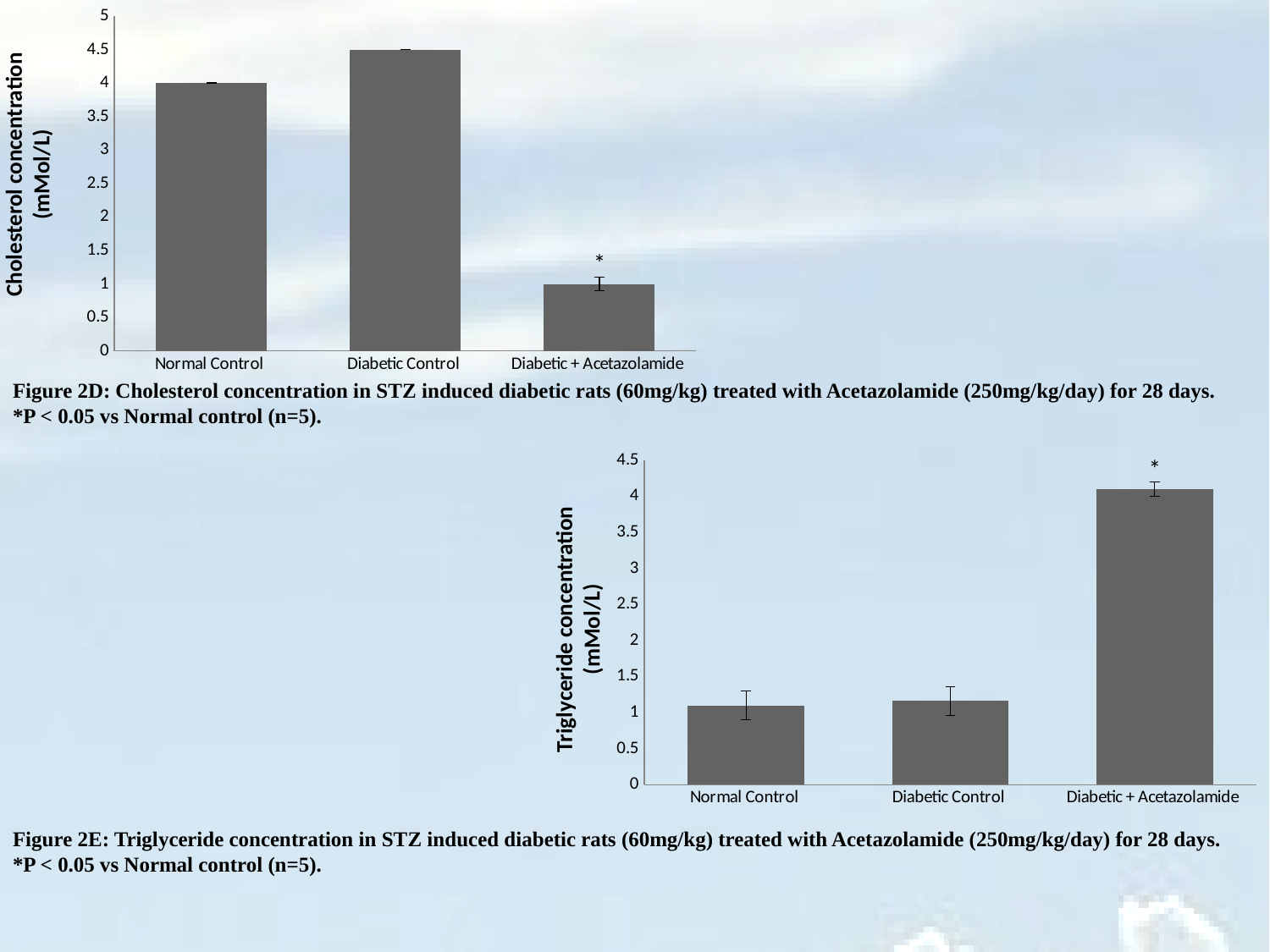
In the cholesterol concentration chart (Figure 2D), which group's bar is marked with an asterisk (*)? Diabetic + Acetazolamide In the triglyceride concentration chart (Figure 2E), which is larger: the value for Diabetic + Acetazolamide or the value for Diabetic Control? Diabetic + Acetazolamide In the cholesterol concentration chart (Figure 2D), which group has the lowest cholesterol concentration? Diabetic + Acetazolamide What type of chart is Figure 2D (cholesterol concentration)? Bar chart In the triglyceride concentration chart (Figure 2E), is the value for Normal Control greater or less than 1.5? less What is the y-axis label of the triglyceride chart (Figure 2E)? Triglyceride concentration (mMol/L) In the triglyceride concentration chart (Figure 2E), is the value for Diabetic + Acetazolamide greater or less than 3.5? greater In the cholesterol concentration chart (Figure 2D), is the value for Diabetic + Acetazolamide greater or less than 1.5? less In the triglyceride concentration chart (Figure 2E), which group has the highest triglyceride concentration? Diabetic + Acetazolamide In the cholesterol concentration chart (Figure 2D), how many groups are plotted? 3 In the cholesterol concentration chart (Figure 2D), which group has the highest cholesterol concentration? Diabetic Control